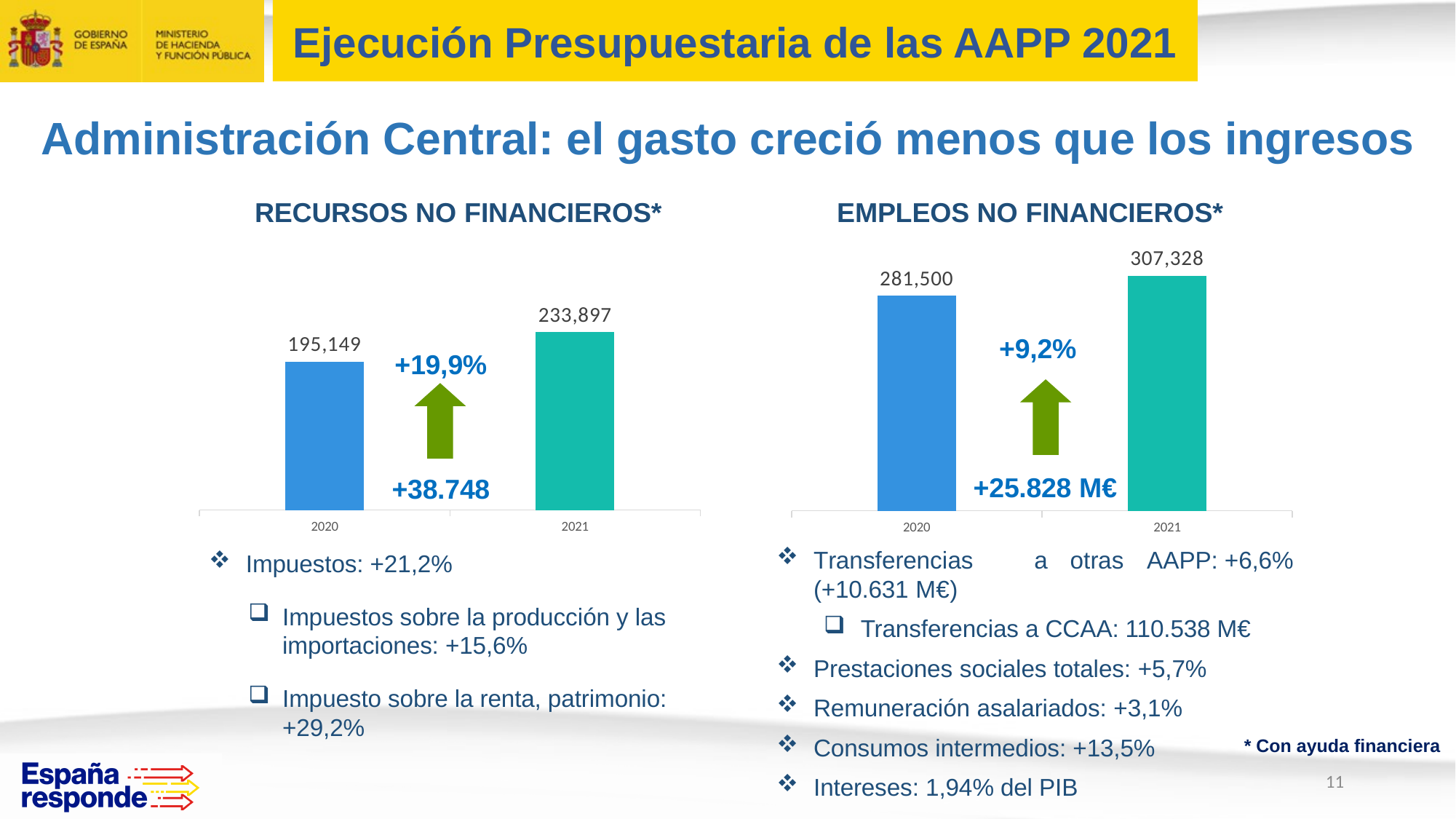
In the RECURSOS NO FINANCIEROS chart, what is the value for 2021? 233,897 In the EMPLEOS NO FINANCIEROS chart, what is the difference between the 2021 and 2020 values? 25,828 In the EMPLEOS NO FINANCIEROS chart, what is the value for 2021? 307,328 In the EMPLEOS NO FINANCIEROS chart, what is the value for 2020? 281,500 In the RECURSOS NO FINANCIEROS chart, do the values rise or fall from 2020 to 2021? rise What kind of chart is the EMPLEOS NO FINANCIEROS chart? bar chart In the RECURSOS NO FINANCIEROS chart, what percentage change is shown between 2020 and 2021? +19,9% In the EMPLEOS NO FINANCIEROS chart, which year has the higher value? 2021 How many bars are shown in the RECURSOS NO FINANCIEROS chart? 2 In the RECURSOS NO FINANCIEROS chart, what is the value for 2020? 195,149 In the RECURSOS NO FINANCIEROS chart, what is the difference between the 2021 and 2020 values? 38,748 In the RECURSOS NO FINANCIEROS chart, which year has the lower value? 2020